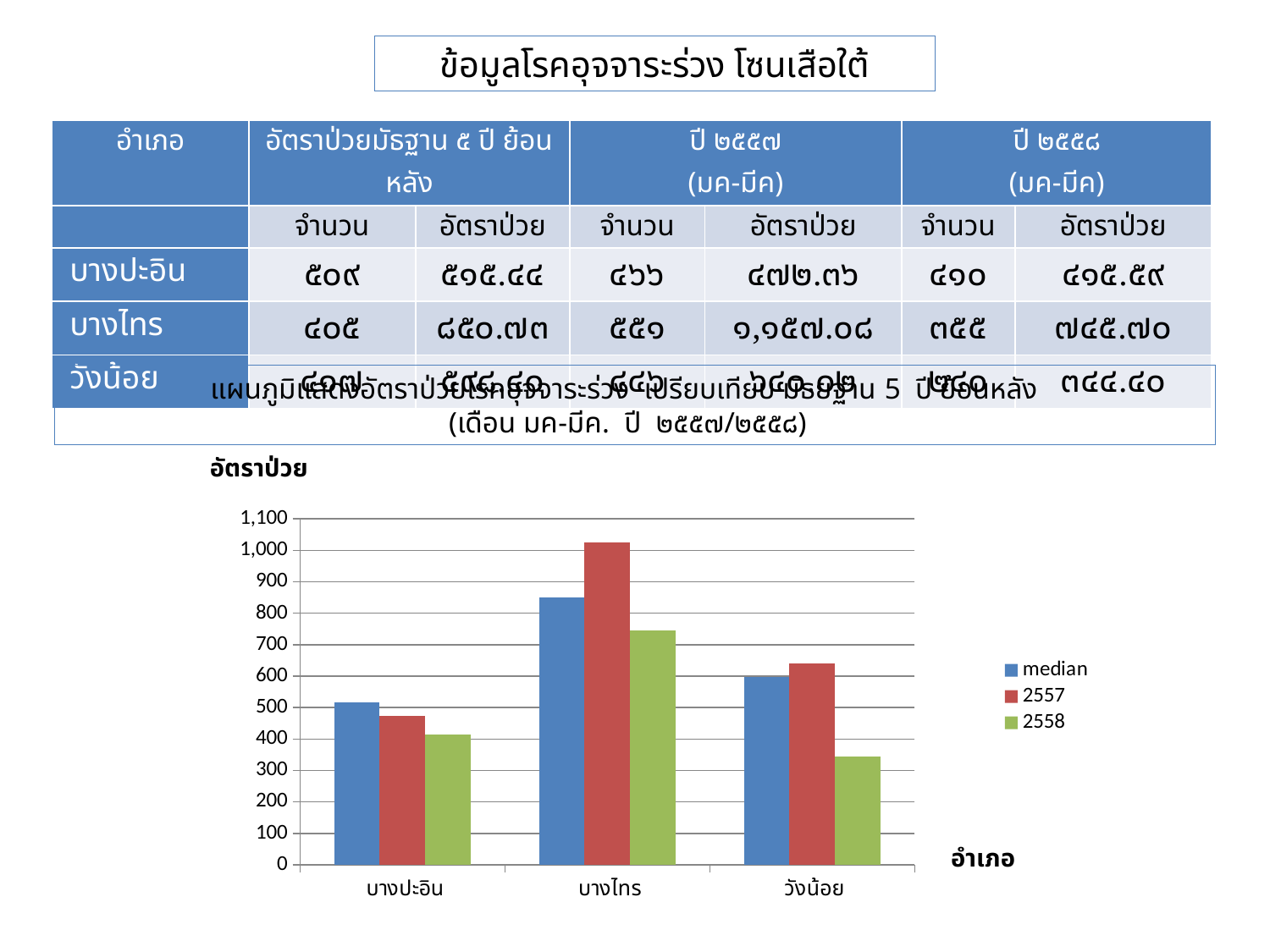
Is the 2558 value for วังน้อย greater or less than 400? less Which district has the highest bar for the 2557 series? บางไทร How many districts (categories) are shown on the x axis of the chart? 3 Which district has the highest median bar? บางไทร How many series does the chart legend list? 3 For วังน้อย, which is larger: the 2557 value or the 2558 value? 2557 Is the 2557 value for บางไทร greater or less than 900? greater Is the median value for บางไทร greater or less than 800? greater What are the three entries listed in the chart legend? median, 2557, 2558 Which district has the lowest bar for the 2558 series? วังน้อย What kind of chart is shown on the slide? bar chart